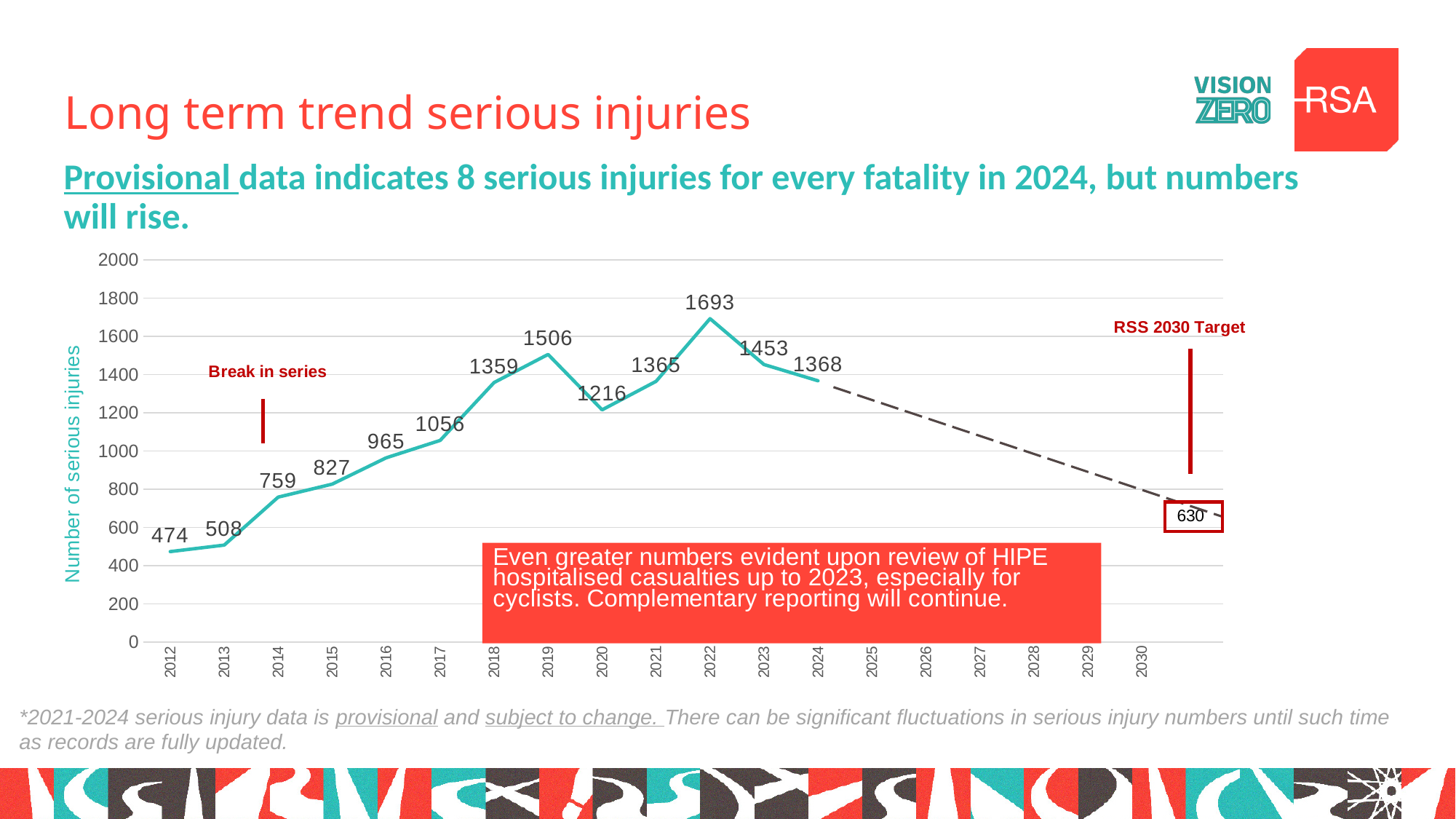
What kind of chart is shown on the slide? Line chart Which year has the highest number of serious injuries on the chart? 2022 What is the label on the y axis of the chart? Number of serious injuries What is the number of serious injuries shown for 2022? 1693 What is the number of serious injuries shown for 2012? 474 How many years from 2012 to 2024 have a data label plotted on the solid line? 13 Which year had more serious injuries, 2019 or 2021? 2019 What is the difference between the serious injuries in 2022 and 2023? 240 What is the RSS 2030 Target value shown on the chart? 630 Which year has the lowest number of serious injuries on the chart? 2012 Did the number of serious injuries rise or fall from 2012 to 2019? Rise What is the provisional number of serious injuries shown for 2024? 1368